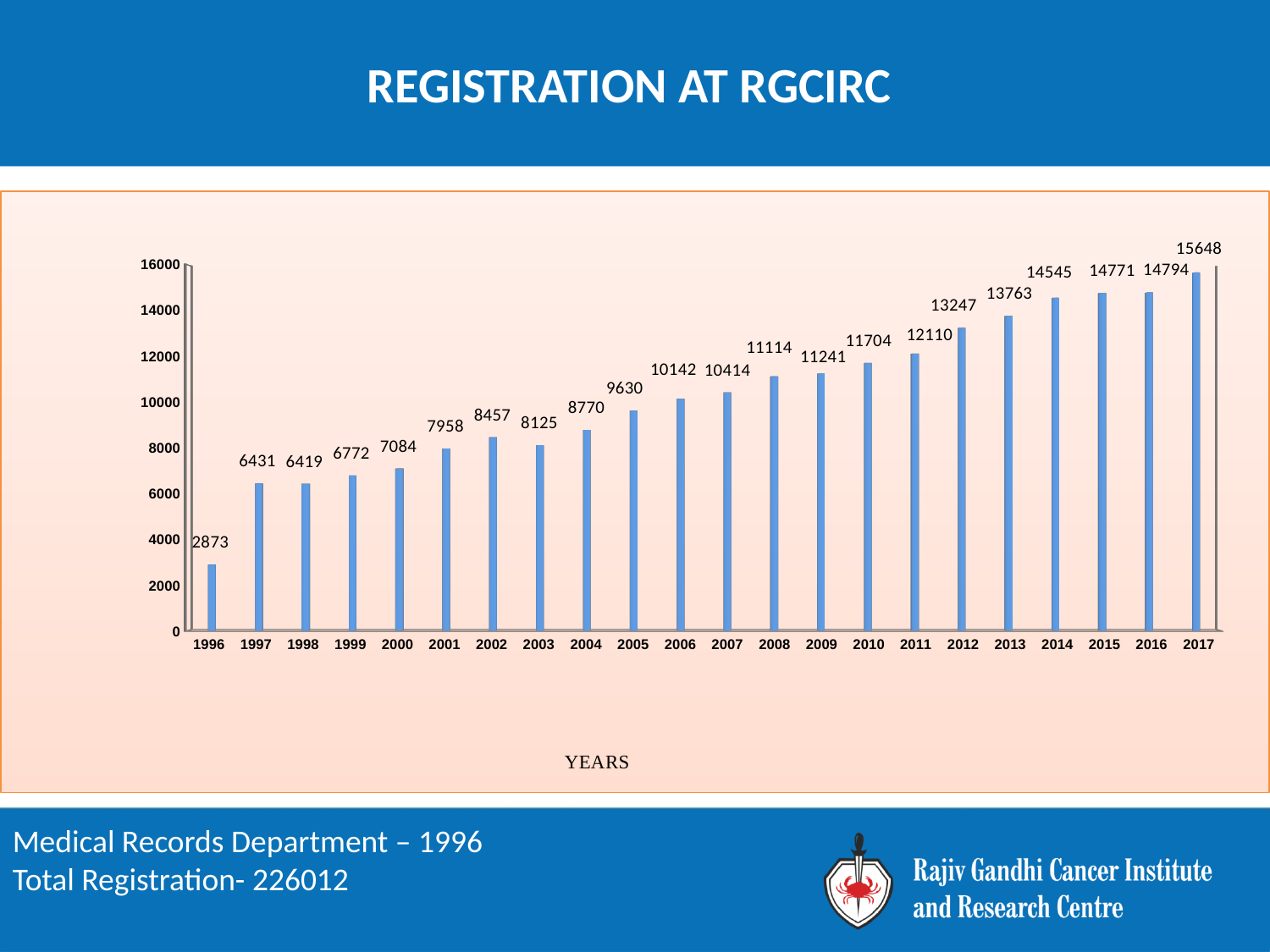
Which year has the lowest registration value? 1996 What is the difference between the registration values for 2000 and 1996? 4211 Which year has a larger registration value, 2002 or 2003? 2002 What is the x-axis label of the chart? YEARS What kind of chart is shown on the slide? bar chart Do the registration values generally rise or fall from 1996 to 2017? rise How many years are shown on the x axis of the chart? 22 Is the registration value for 2009 greater or less than 12000? less What is the registration value for 2005? 9630 What is the registration value for 2012? 13247 What is the difference between the registration values for 2017 and 2016? 854 Which year has the highest registration value? 2017